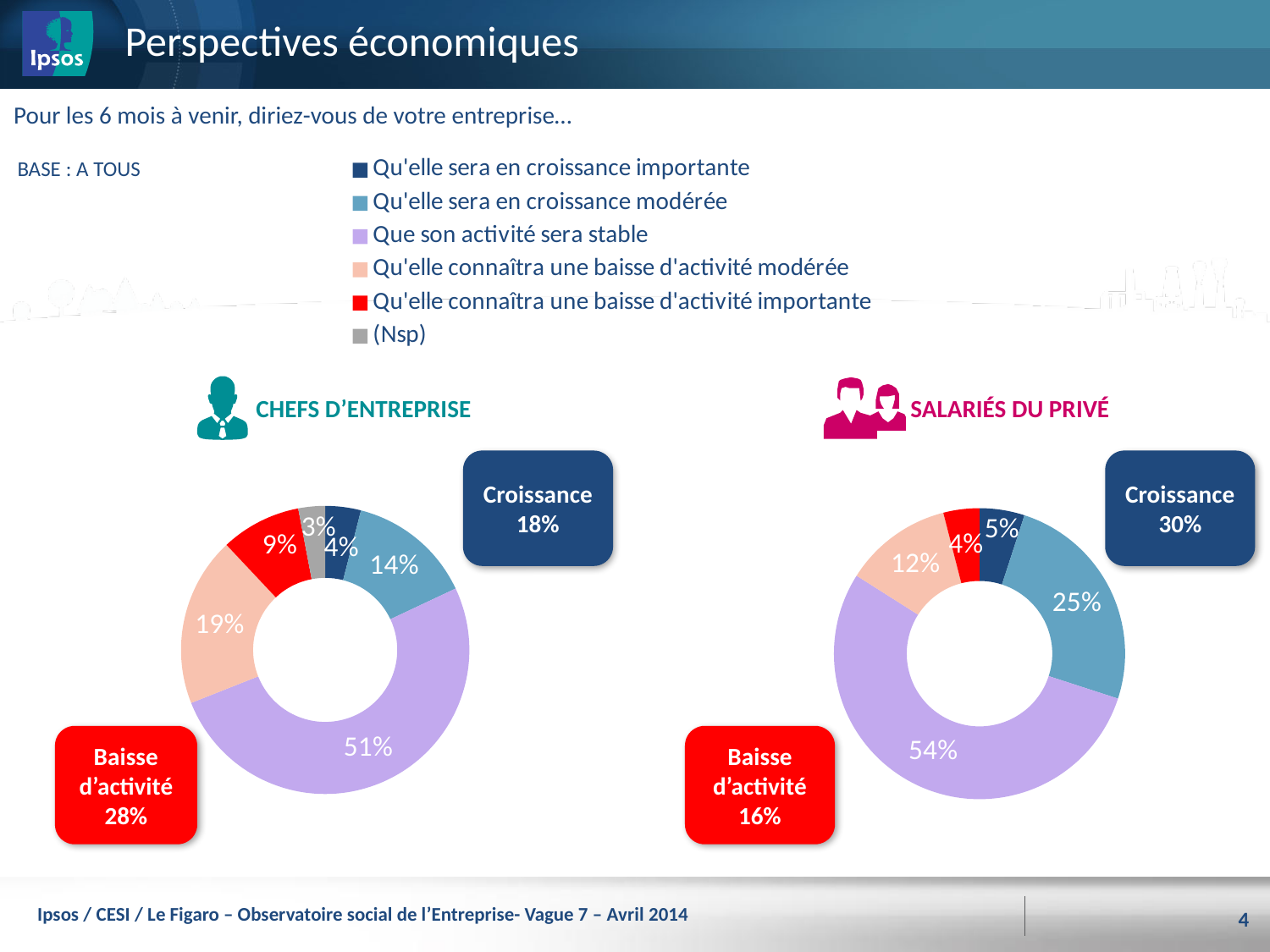
How many response categories does the legend list? 6 In the SALARIÉS DU PRIVÉ chart, what percentage say their company will be in moderate growth ("Qu'elle sera en croissance modérée")? 25% What total "Baisse d'activité" percentage is shown in the callout for the CHEFS D'ENTREPRISE chart? 28% Which chart shows a larger share for "Qu'elle connaîtra une baisse d'activité modérée": CHEFS D'ENTREPRISE or SALARIÉS DU PRIVÉ? CHEFS D'ENTREPRISE What type of chart is used for CHEFS D'ENTREPRISE and SALARIÉS DU PRIVÉ? Donut (pie) chart What total "Croissance" percentage is shown in the callout for the SALARIÉS DU PRIVÉ chart? 30% In the CHEFS D'ENTREPRISE chart, what percentage of respondents say their company's activity will be stable ("Que son activité sera stable")? 51% In the CHEFS D'ENTREPRISE chart, what percentage say their company will experience a significant drop in activity ("Qu'elle connaîtra une baisse d'activité importante")? 9% In the CHEFS D'ENTREPRISE chart, which response has the largest share? Que son activité sera stable What is the difference between the "Que son activité sera stable" share in the SALARIÉS DU PRIVÉ chart and the same share in the CHEFS D'ENTREPRISE chart? 3 percentage points In the CHEFS D'ENTREPRISE chart, which response has the smallest share? (Nsp) In the SALARIÉS DU PRIVÉ chart, what percentage say their company will be in significant growth ("Qu'elle sera en croissance importante")? 5%